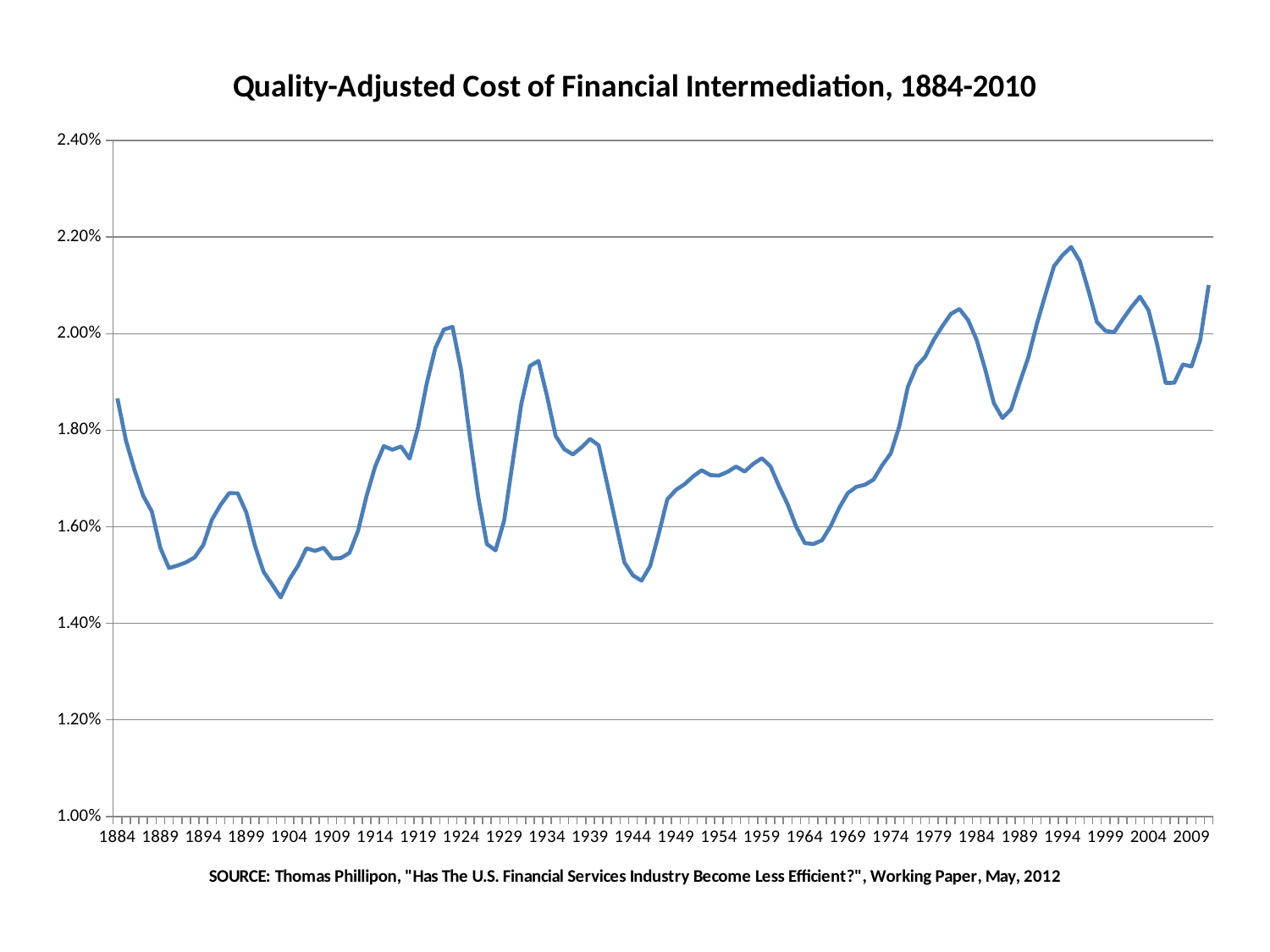
Is the value for 2009 greater or less than 1.80%? greater Which year has the larger value, 1944 or 1994? 1994 Is the value for 1994 greater or less than 2.00%? greater Does the value rise or fall between 1964 and 1984? rise Is the value for 1964 greater or less than 1.80%? less What is the title of the chart? Quality-Adjusted Cost of Financial Intermediation, 1884-2010 Which year has the larger value, 1884 or 1904? 1884 What kind of chart is shown on the slide? line chart What is the highest value shown on the vertical axis? 2.40%